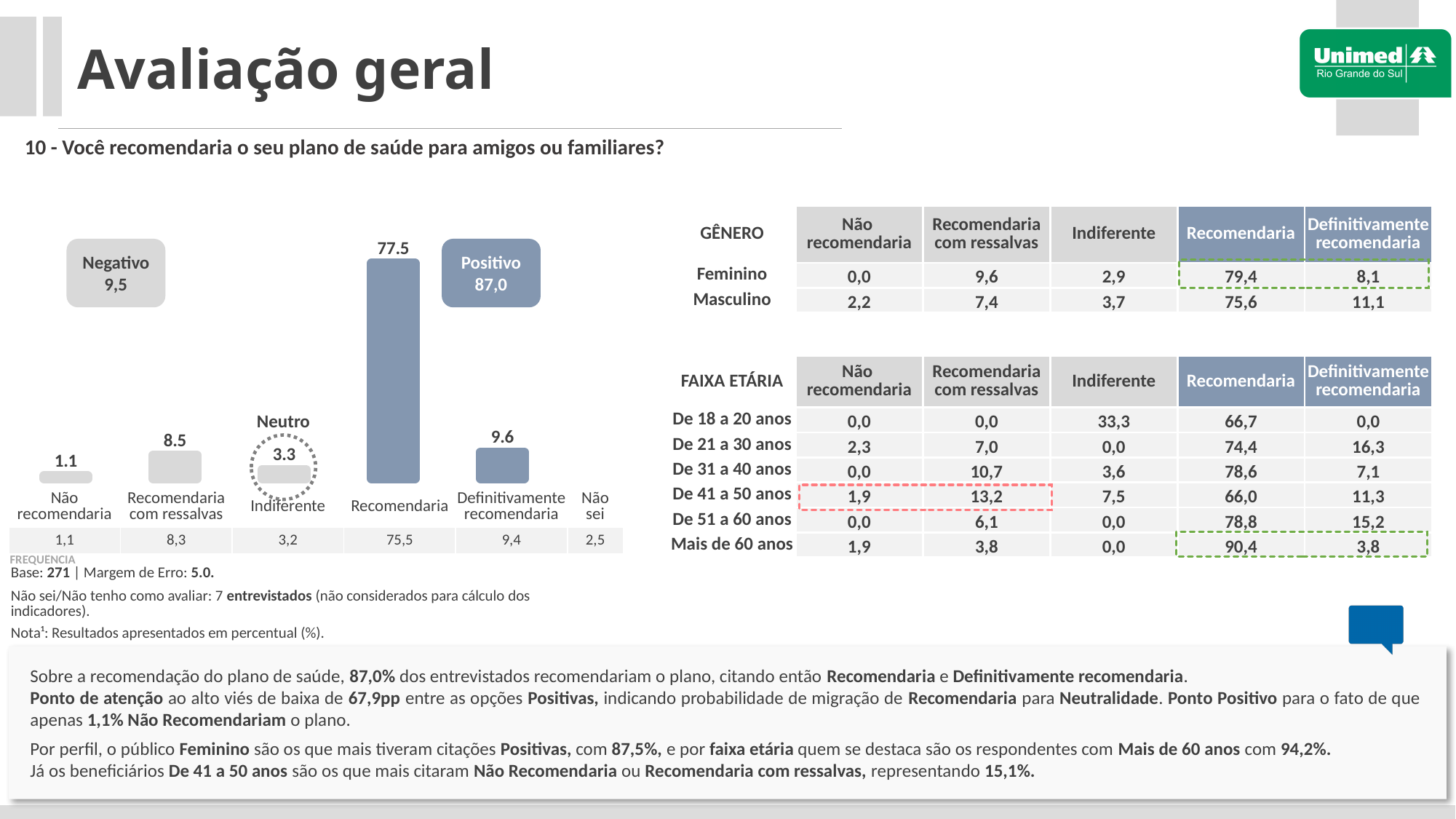
In the bar chart, what is the value for Não recomendaria? 1.1 In the bar chart, what is the value for Indiferente? 3.3 In the bar chart, which is larger: Definitivamente recomendaria or Recomendaria com ressalvas? Definitivamente recomendaria In the bar chart, what is the value for Recomendaria com ressalvas? 8.5 In the bar chart, which category has the highest value? Recomendaria In the bar chart, which category has the lowest value? Não recomendaria In the bar chart, what is the value for Recomendaria? 77.5 In the bar chart, what is the value for Definitivamente recomendaria? 9.6 In the bar chart, what is the difference between the values for Recomendaria and Definitivamente recomendaria? 67.9 What value is shown in the Positivo box above the bar chart? 87,0 What kind of chart is shown on the left of the slide? Bar chart How many bars are plotted in the bar chart? 5